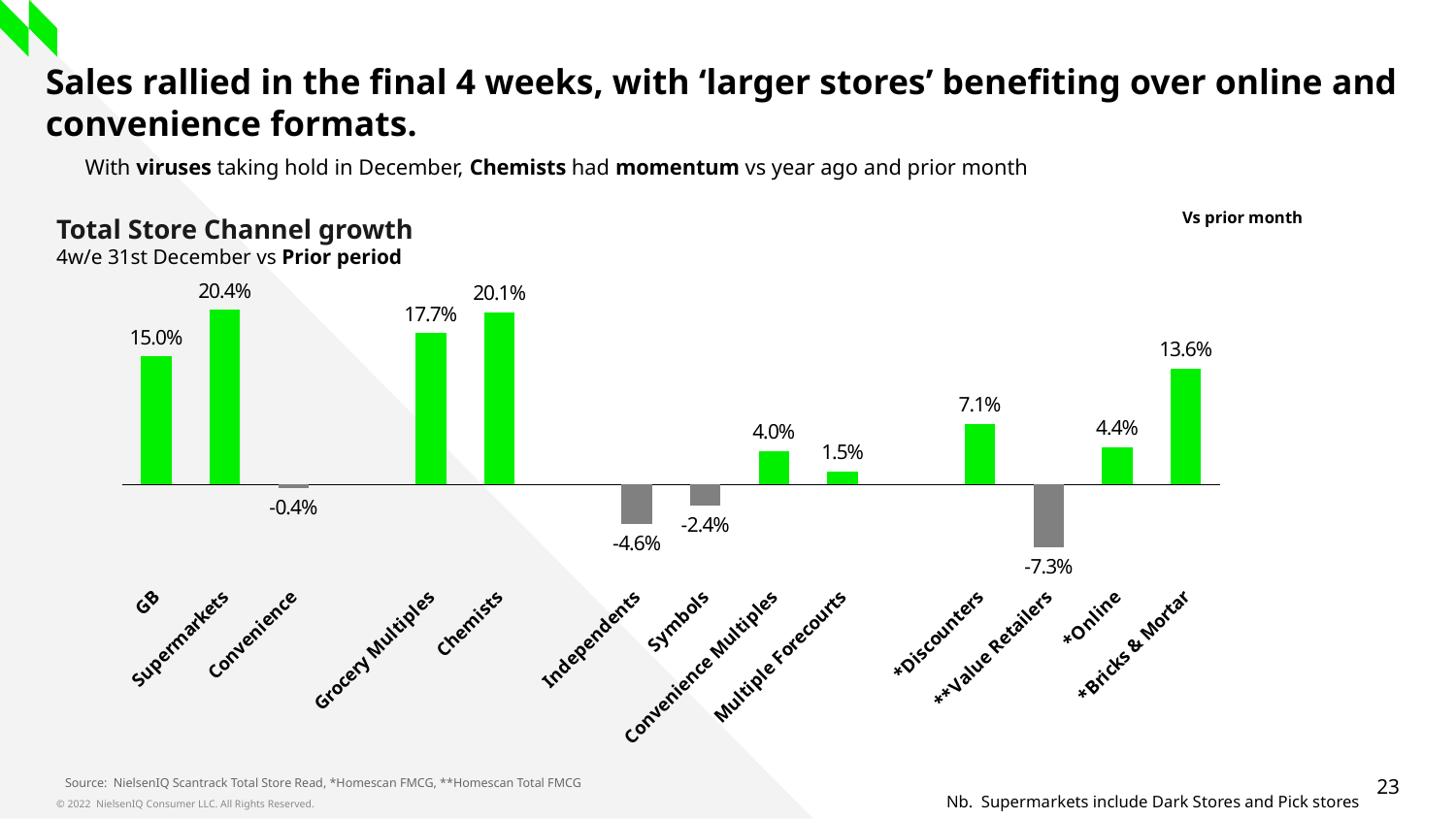
What kind of chart is the Total Store Channel growth chart? Bar chart What is the value for Chemists in the Total Store Channel growth chart? 20.1% Which category has the lowest value in the Total Store Channel growth chart? **Value Retailers Which is larger in the Total Store Channel growth chart, Grocery Multiples or *Bricks & Mortar? Grocery Multiples What is the value for Independents in the Total Store Channel growth chart? -4.6% How many categories are shown in the Total Store Channel growth chart? 13 What is the value for *Bricks & Mortar in the Total Store Channel growth chart? 13.6% What is the difference between the values for Supermarkets and GB in the Total Store Channel growth chart? 5.4% What is the difference between the values for *Discounters and *Online in the Total Store Channel growth chart? 2.7% What is the value for Convenience in the Total Store Channel growth chart? -0.4% What period does the subtitle of the Total Store Channel growth chart say the data covers? 4w/e 31st December vs Prior period Which category has the highest value in the Total Store Channel growth chart? Supermarkets